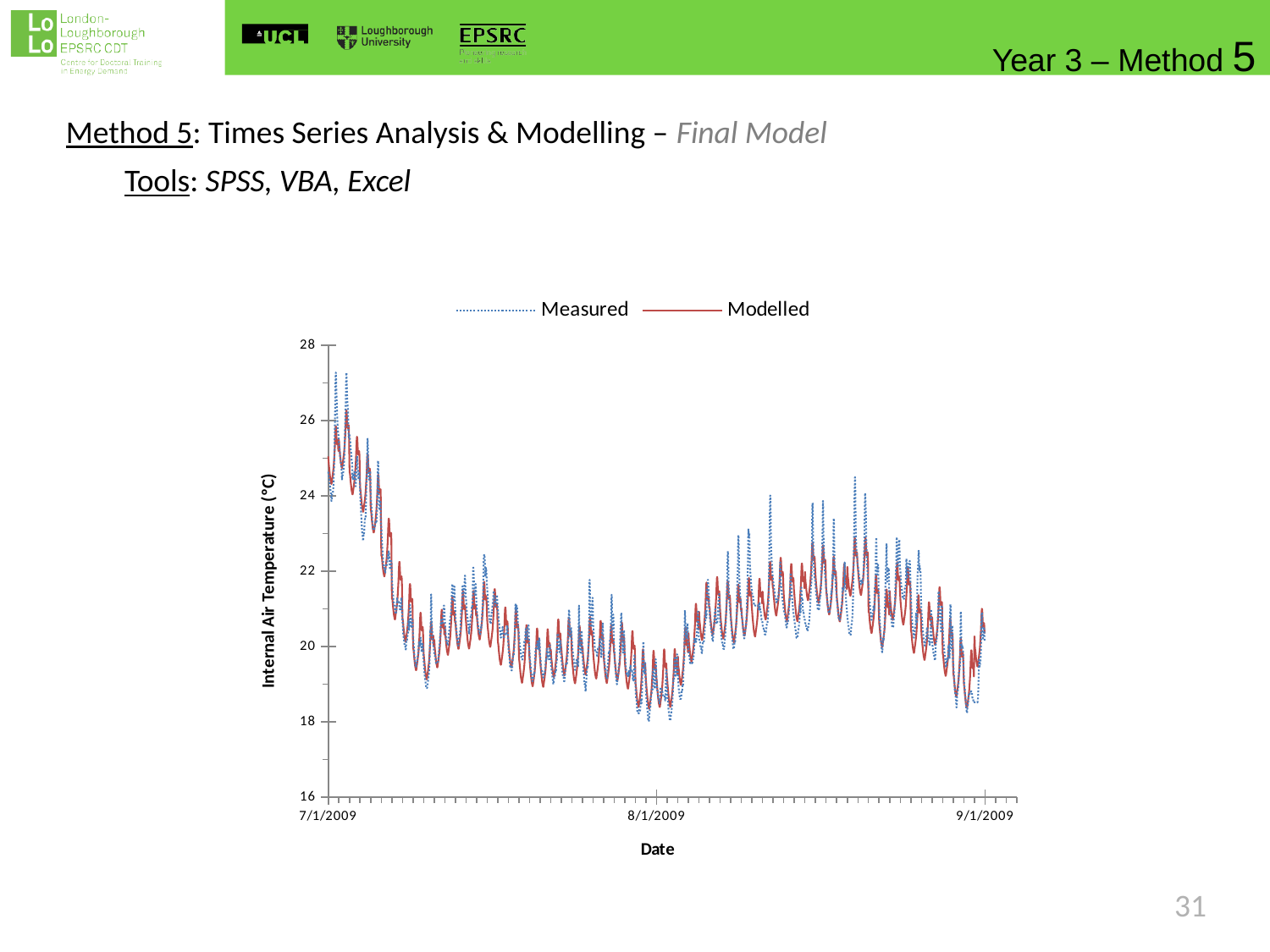
Do the internal air temperatures generally rise or fall between 7/1/2009 and 8/1/2009? fall How many dates are labelled on the horizontal axis? 3 What is the title of the vertical axis? Internal Air Temperature (°C) Is the Modelled internal air temperature around 8/1/2009 greater or less than 22? less Which series is drawn as a dotted line, Measured or Modelled? Measured Is the lowest Measured value around early August 2009 greater or less than 20? less What are the two series named in the legend? Measured and Modelled How many series does the legend list? 2 Is the Measured internal air temperature at the start of the chart (7/1/2009) greater or less than 22? greater What kind of chart is shown on the slide? line chart